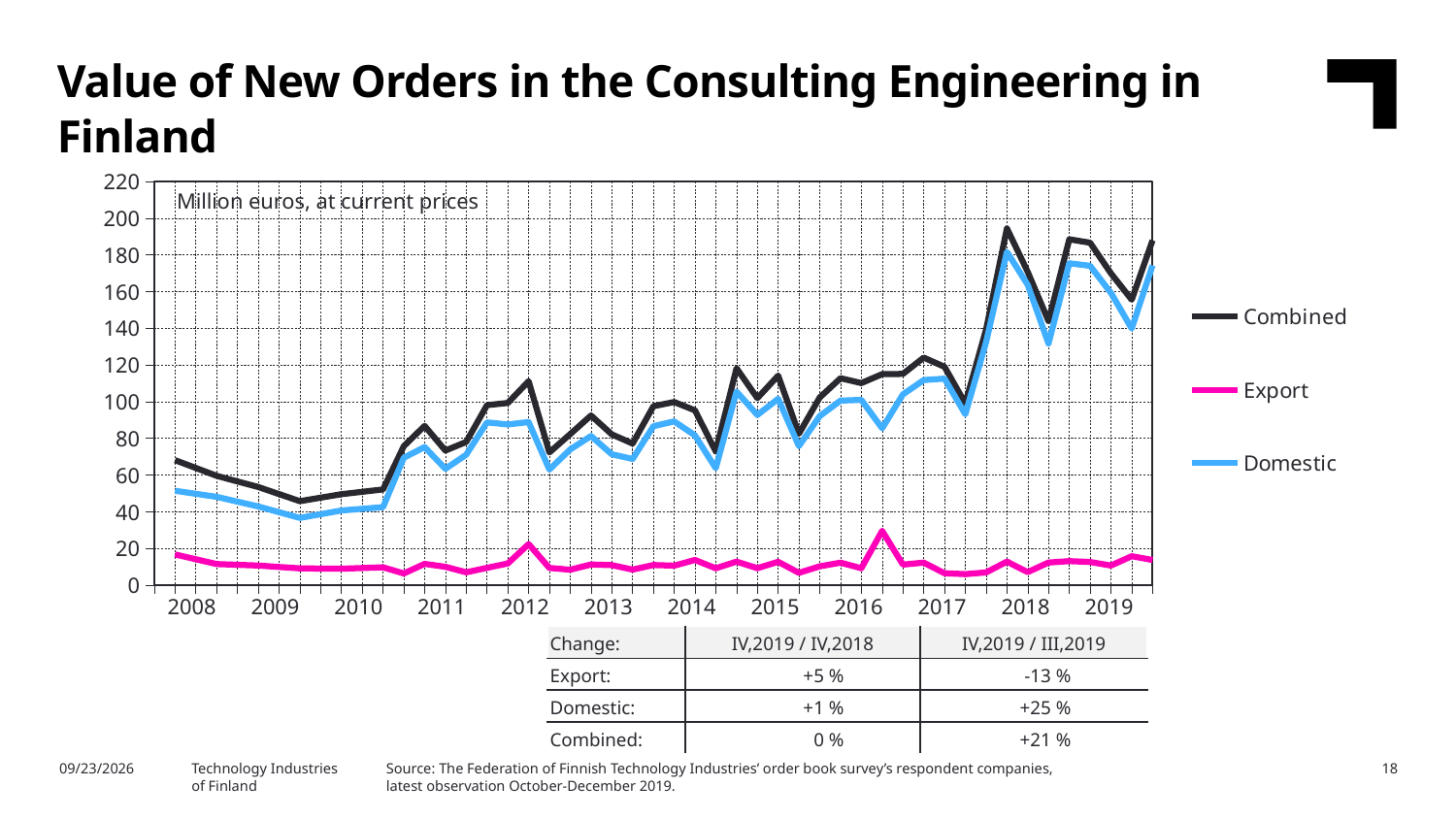
What type of chart is shown on the slide? line chart Is the peak value of the Combined series in 2018 greater or less than 180? greater Which series has the highest values throughout the chart? Combined Which series are listed in the legend? Combined, Export, Domestic What unit is stated in the label inside the chart area? Million euros, at current prices Which series has the lowest values throughout the chart? Export Does the Combined series rise or fall between 2017 and 2018? rise In 2018, which is larger, the Domestic series or the Export series? Domestic Is the Combined value at the end of 2019 greater or less than 160? greater Is the highest value of the Export series (around 2016) greater or less than 40? less How many series does the legend list? 3